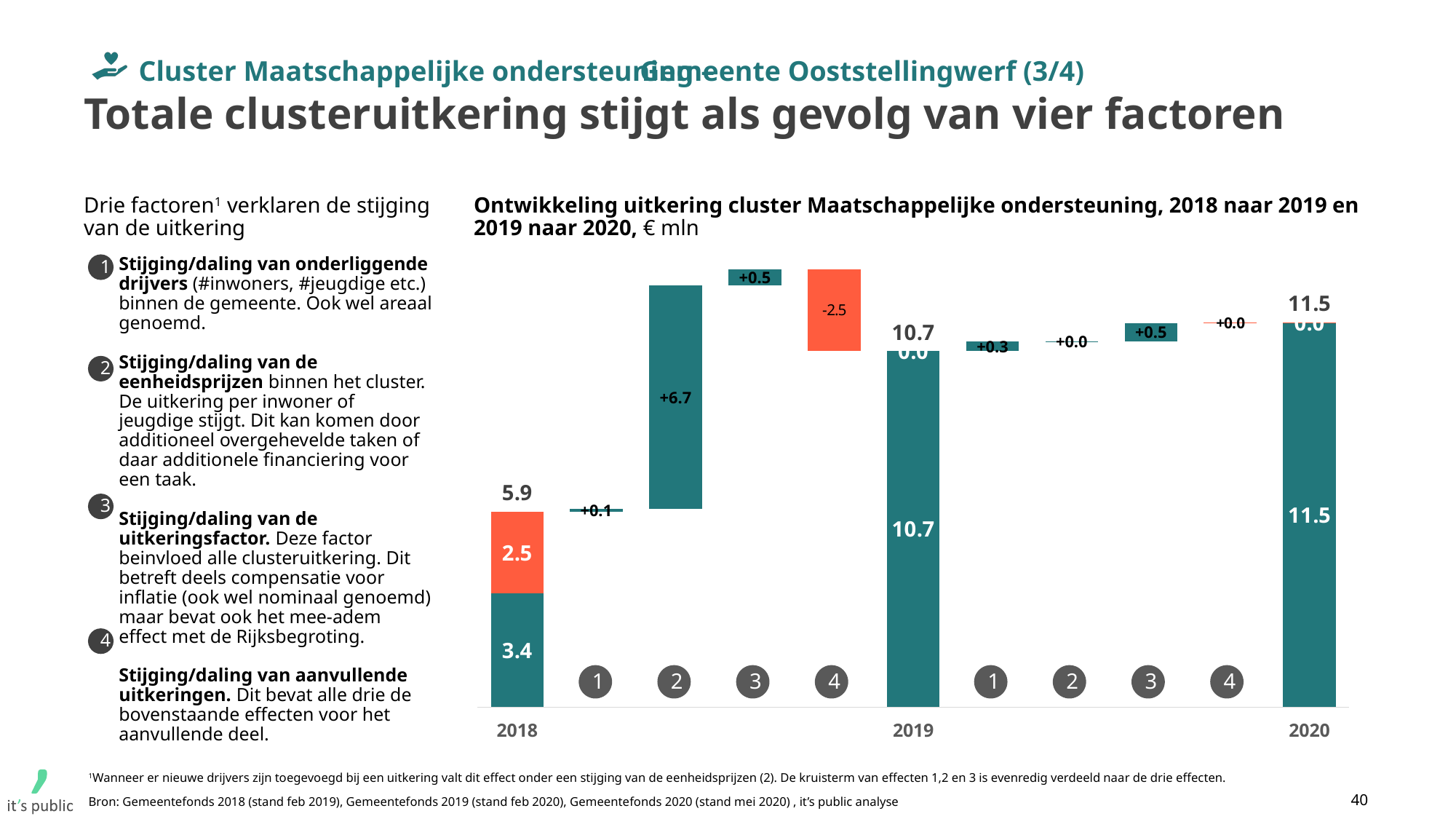
What is the value of the orange segment in the 2018 bar? 2.5 What is the total uitkering shown for 2018? 5.9 Do the yearly totals rise or fall from 2018 to 2020? Rise Is the 2019 total larger or smaller than the 2018 total? Larger Which factor has the largest effect in the step from 2018 to 2019? Factor 2 (+6.7) What is the effect of factor 1 in the step from 2019 to 2020? +0.3 What is the difference between the 2020 total and the 2018 total? 5.6 What is the total uitkering shown for 2019? 10.7 In what unit are the values in the chart expressed? € mln What is the effect of factor 4 in the step from 2018 to 2019? -2.5 What is the effect of factor 2 in the step from 2018 to 2019? +6.7 What is the total uitkering shown for 2020? 11.5